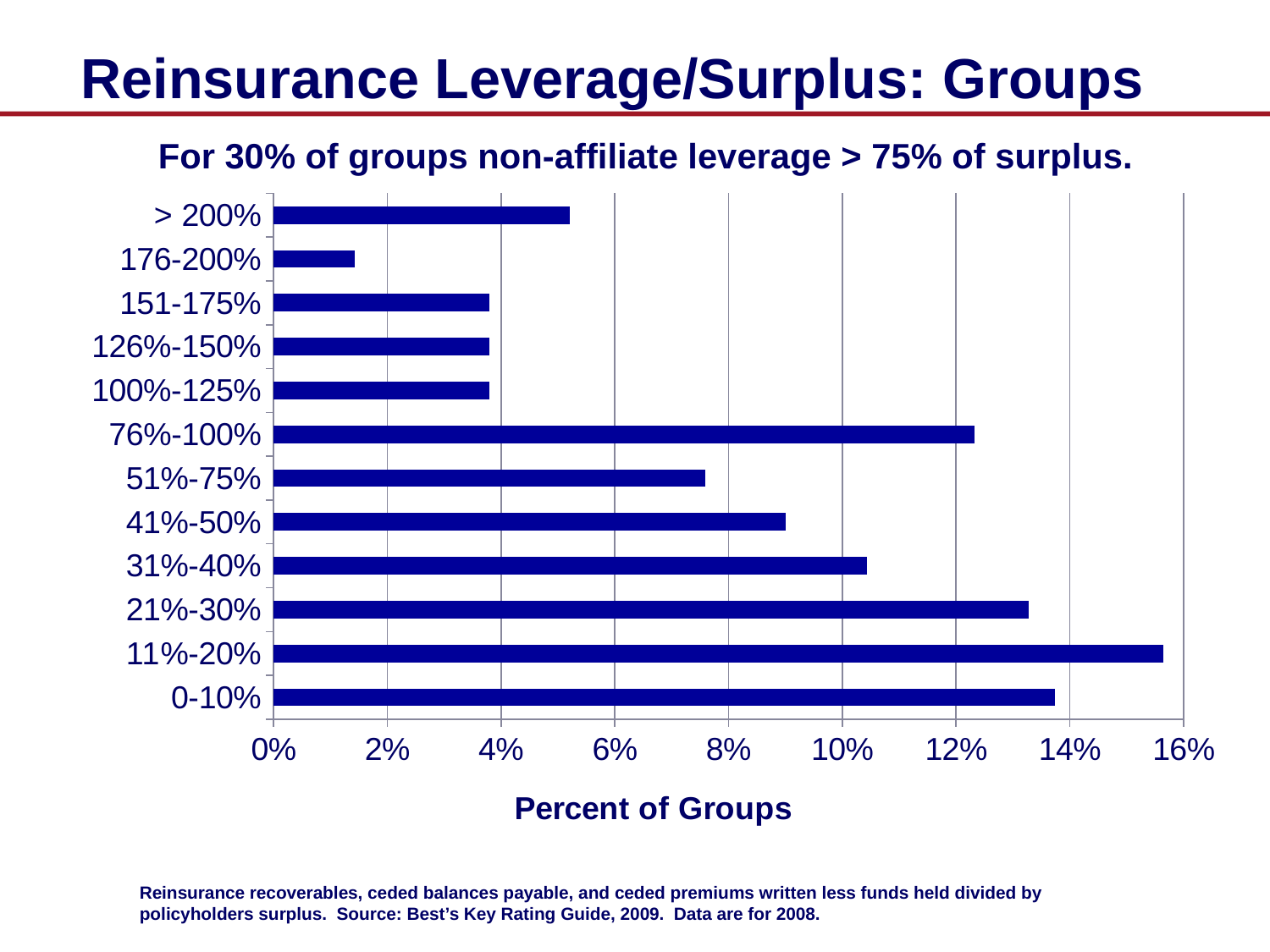
Which leverage category has the lowest percent of groups? 176-200% What kind of chart is shown on the slide? bar chart Which has a larger percent of groups: the 76%-100% category or the 51%-75% category? 76%-100% Which leverage category has the highest percent of groups? 11%-20% Is the percent of groups for the 76%-100% category greater or less than 10%? greater What is the label of the horizontal axis of the chart? Percent of Groups Is the percent of groups for the 51%-75% category greater or less than 8%? less Is the percent of groups for the 176-200% category greater or less than 2%? less Which has a larger percent of groups: the 41%-50% category or the 100%-125% category? 41%-50% How many leverage categories are plotted on the chart? 12